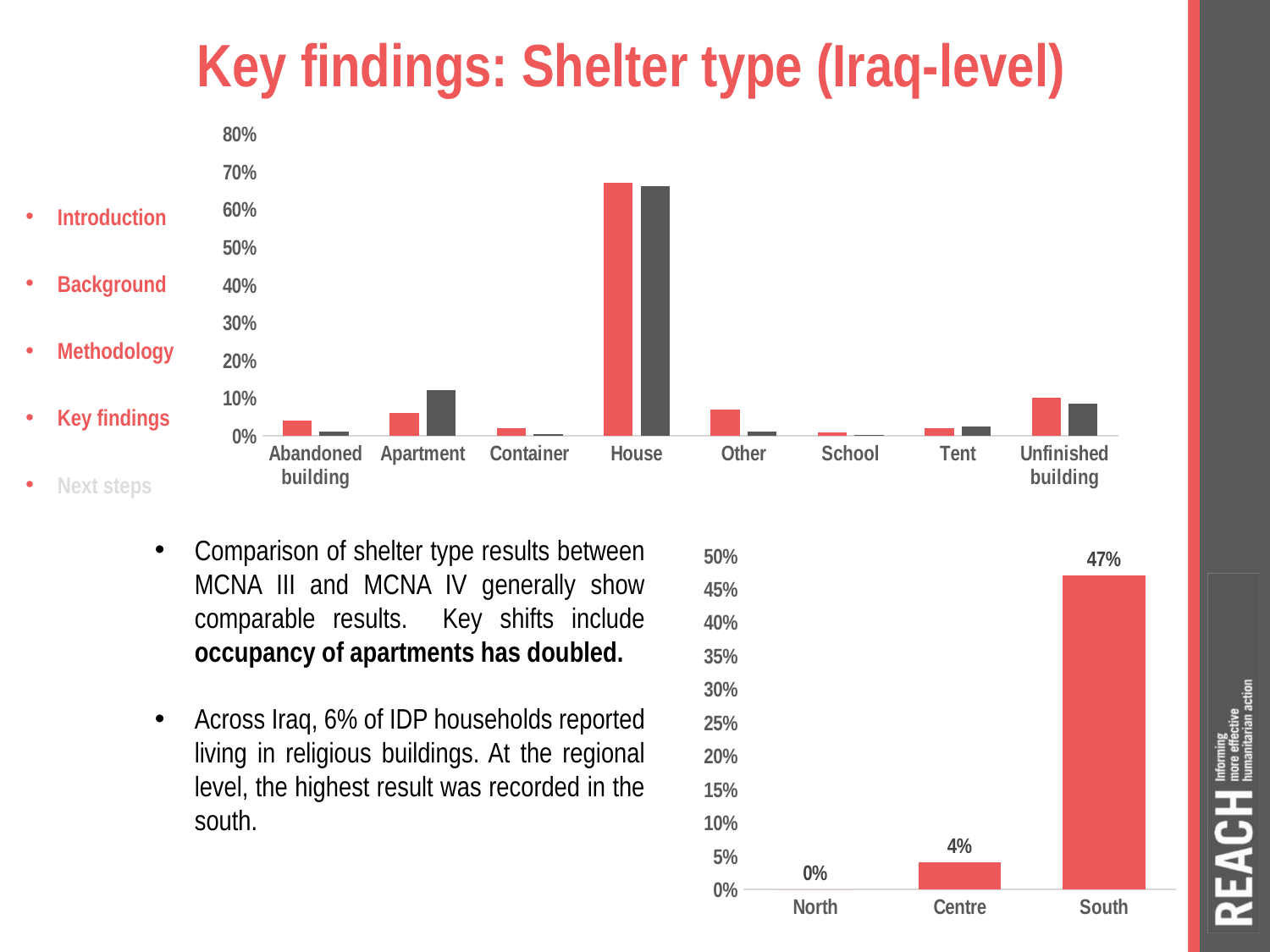
In the top chart showing shelter types, how many shelter type categories are shown on the x axis? 8 In the bottom chart (North, Centre, South), what is the value for North? 0% In the bottom chart (North, Centre, South), which region has the lowest value? North What kind of chart is the top chart showing shelter types? Bar chart In the top chart showing shelter types, which shelter type has the highest values? House In the bottom chart (North, Centre, South), what is the difference between the values for South and Centre? 43% In the bottom chart (North, Centre, South), is the value for South greater or less than 45%? greater In the bottom chart (North, Centre, South), what is the value for Centre? 4% In the top chart showing shelter types, is the red bar for House greater or less than 60%? greater In the bottom chart (North, Centre, South), how many regions are shown? 3 In the bottom chart (North, Centre, South), which region has the highest value? South In the bottom chart (North, Centre, South), what is the value for South? 47%